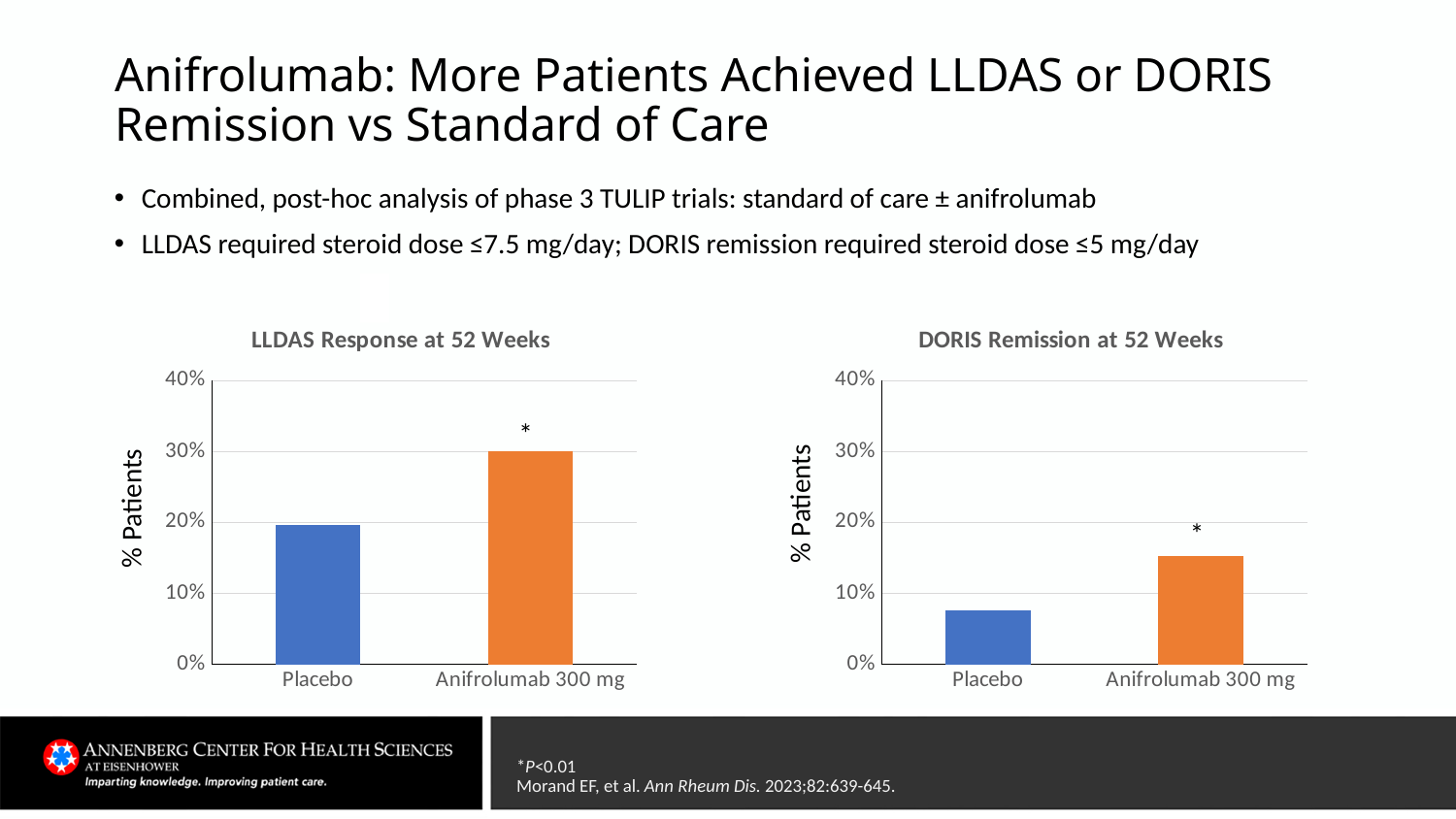
In the DORIS Remission at 52 Weeks chart, is the value for Placebo greater or less than 10%? less What kind of chart is the LLDAS Response at 52 Weeks chart? bar chart In the LLDAS Response at 52 Weeks chart, which group has the higher value? Anifrolumab 300 mg In the DORIS Remission at 52 Weeks chart, is the value for Anifrolumab 300 mg greater or less than 10%? greater In the DORIS Remission at 52 Weeks chart, is the value for Anifrolumab 300 mg greater or less than 20%? less What is the maximum value shown on the y-axis of the DORIS Remission at 52 Weeks chart? 40% In the DORIS Remission at 52 Weeks chart, which group has the lower value? Placebo Is the Anifrolumab 300 mg bar in the LLDAS Response at 52 Weeks chart taller than the Anifrolumab 300 mg bar in the DORIS Remission at 52 Weeks chart? Yes What is the y-axis label of the LLDAS Response at 52 Weeks chart? % Patients How many categories are shown in the DORIS Remission at 52 Weeks chart? 2